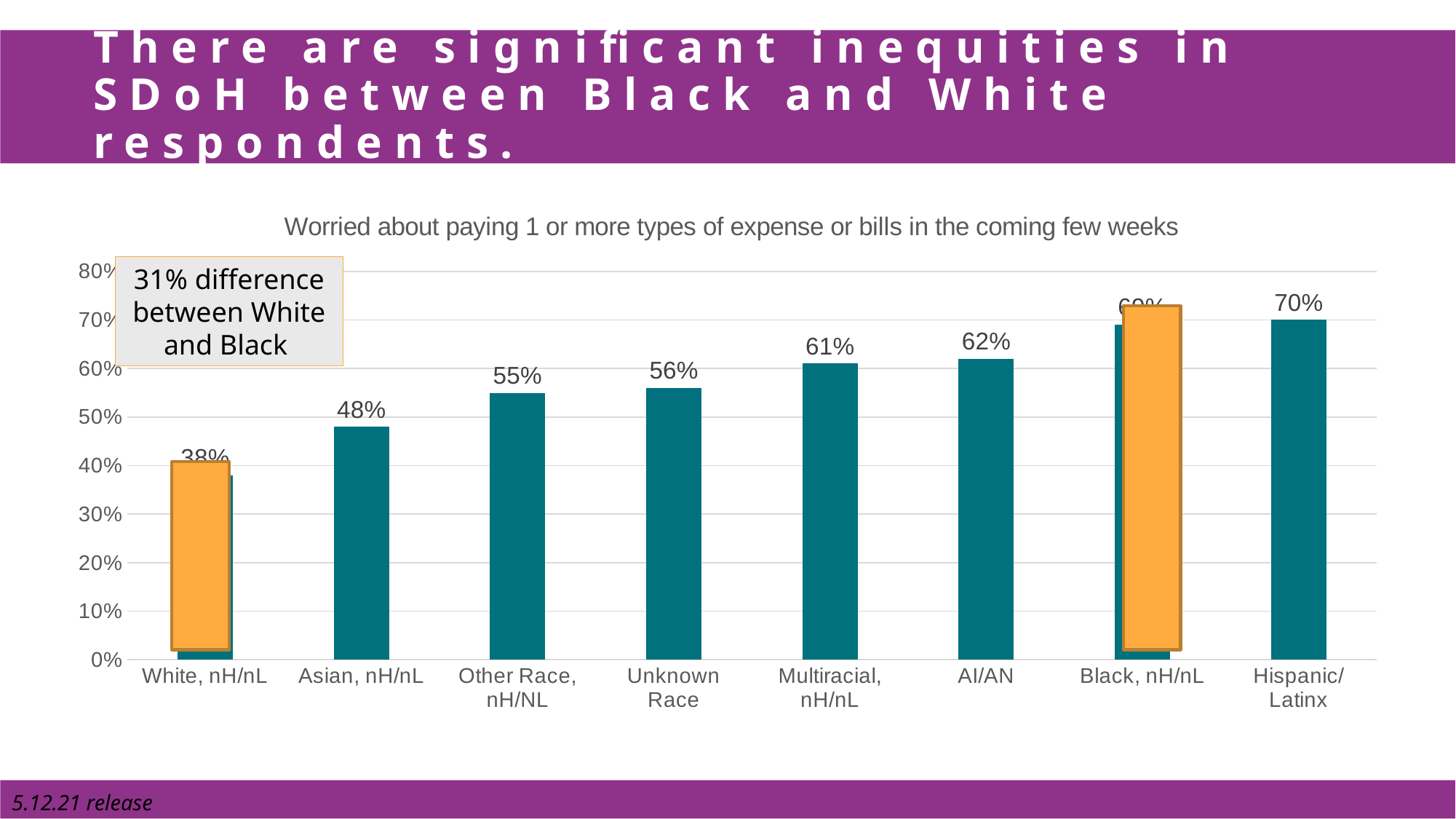
Do the values generally rise or fall from left to right along the x axis? rise What is the difference between the values for Multiracial, nH/nL and Asian, nH/nL? 13% What is the value for Other Race, nH/NL? 55% Which is larger, the value for AI/AN or the value for Asian, nH/nL? AI/AN What is the value for Asian, nH/nL? 48% What is the value for Hispanic/Latinx? 70% Which category has the lowest value? White, nH/nL What is the value for Unknown Race? 56% What is the value for Multiracial, nH/nL? 61% What is the value for AI/AN? 62% How many categories are shown on the x axis of the chart? 8 What kind of chart is shown on the slide? bar chart